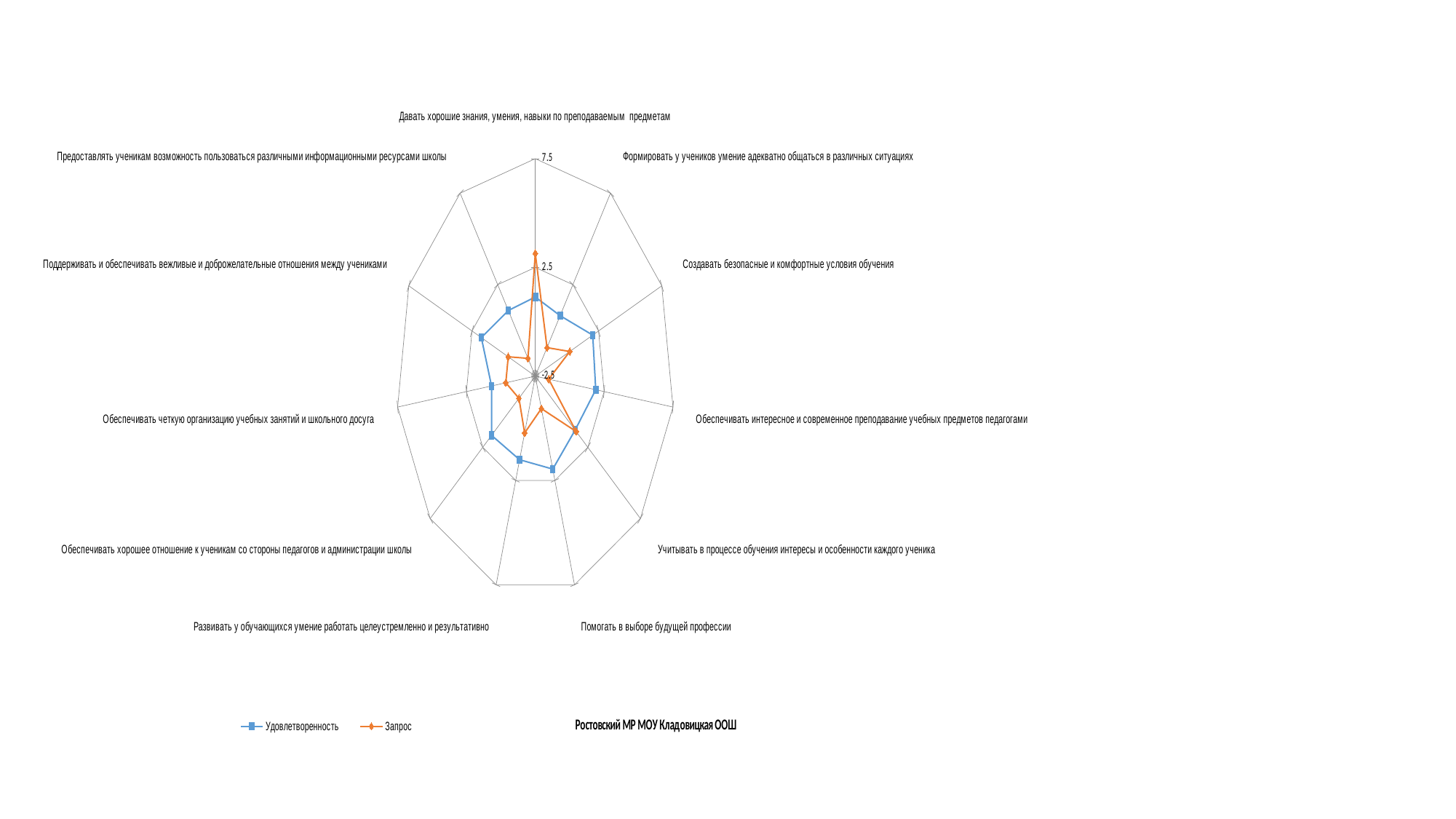
Is the Запрос value for 'Давать хорошие знания, умения, навыки по преподаваемым предметам' greater or less than 2.5? greater For 'Давать хорошие знания, умения, навыки по преподаваемым предметам', which series has the larger value, Удовлетворенность or Запрос? Запрос For 'Создавать безопасные и комфортные условия обучения', which series has the larger value, Удовлетворенность or Запрос? Удовлетворенность For 'Обеспечивать хорошее отношение к ученикам со стороны педагогов и администрации школы', which series has the larger value, Удовлетворенность or Запрос? Удовлетворенность What kind of chart is shown on the slide? Radar chart Which series is drawn with orange diamond markers? Запрос Is the Запрос value for 'Обеспечивать четкую организацию учебных занятий и школьного досуга' greater or less than 2.5? less How many categories (axes) does the radar chart have? 11 For which category is the Запрос value highest? Давать хорошие знания, умения, навыки по преподаваемым предметам What are the two series named in the legend? Удовлетворенность and Запрос Is the Удовлетворенность value for 'Создавать безопасные и комфортные условия обучения' greater or less than 2.5? less How many series does the legend list? 2